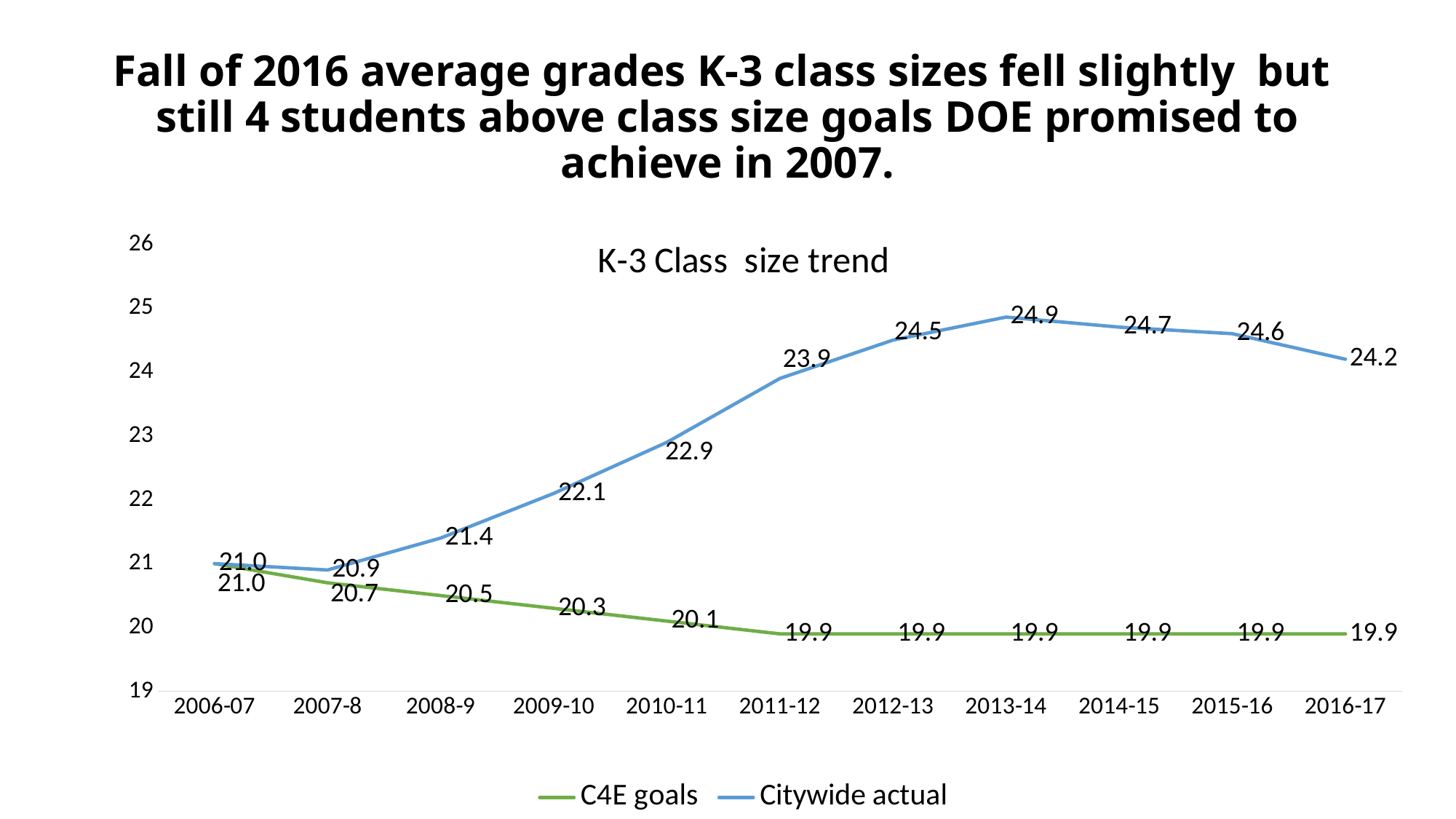
What kind of chart is shown on the slide? Line chart What is the Citywide actual value for 2016-17? 24.2 How many series does the legend list? 2 Does the C4E goals series rise or fall from 2006-07 to 2011-12? Fall What is the C4E goals value for 2009-10? 20.3 What is the title of the chart? K-3 Class size trend Which series has the larger value in 2011-12, C4E goals or Citywide actual? Citywide actual In which school year is the Citywide actual value lowest? 2007-8 What is the Citywide actual value for 2013-14? 24.9 What is the difference between the Citywide actual and C4E goals values in 2016-17? 4.3 How many school years are shown on the x axis? 11 In which school year does the Citywide actual series reach its highest value? 2013-14